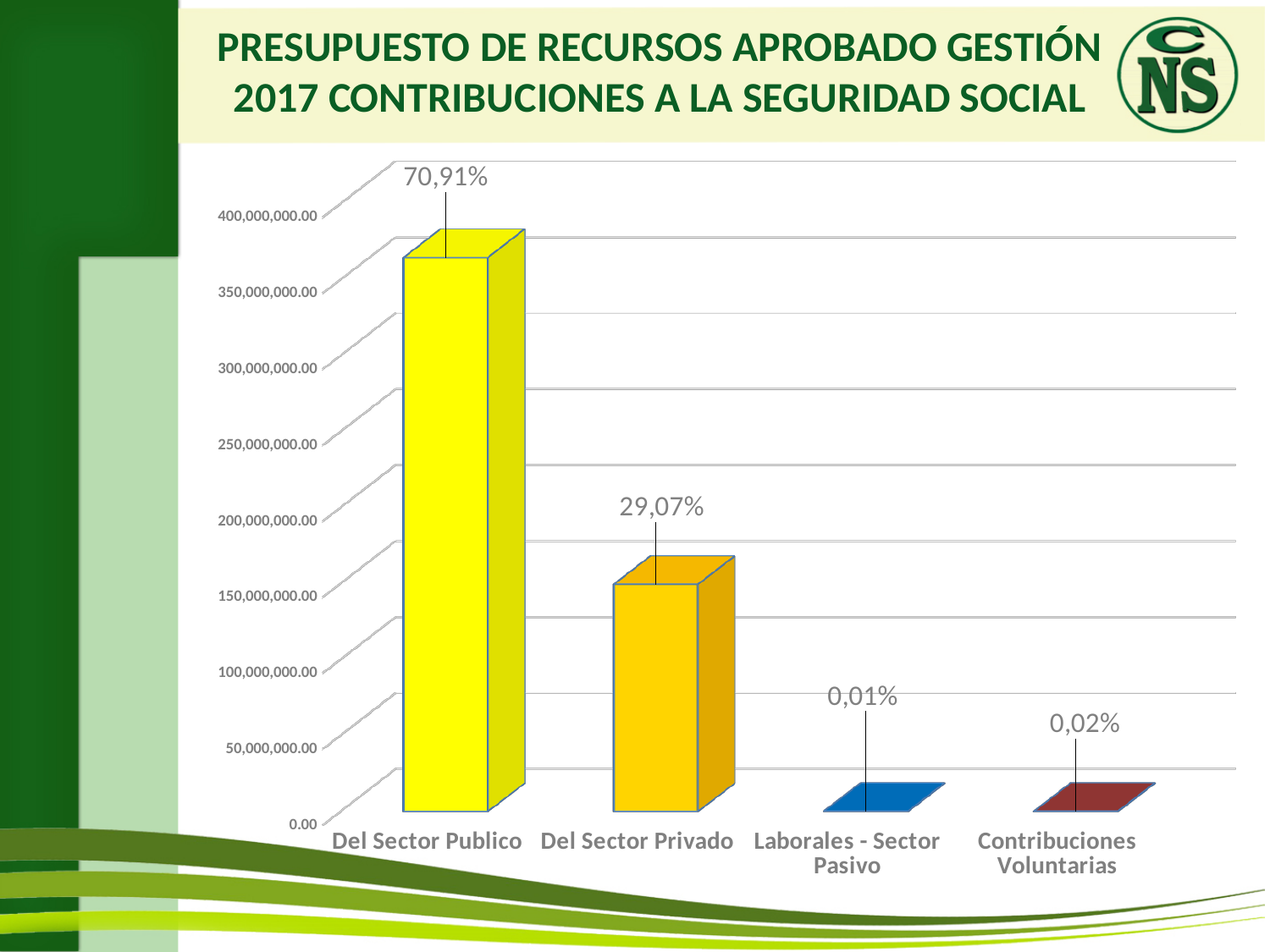
Which category has the lowest percentage label? Laborales - Sector Pasivo Is the value for Del Sector Publico greater or less than 350,000,000.00? greater What percentage label is shown for Del Sector Publico? 70,91% How many categories are shown on the x axis? 4 What is the difference in percentage points between the labels for Del Sector Publico and Del Sector Privado? 41,84% Is the value for Del Sector Privado greater or less than 200,000,000.00? less What kind of chart is shown on the slide? Bar chart Which is larger, the value for Del Sector Privado or the value for Contribuciones Voluntarias? Del Sector Privado What percentage label is shown for Laborales - Sector Pasivo? 0,01% Which category has the highest value? Del Sector Publico What percentage label is shown for Del Sector Privado? 29,07% What percentage label is shown for Contribuciones Voluntarias? 0,02%